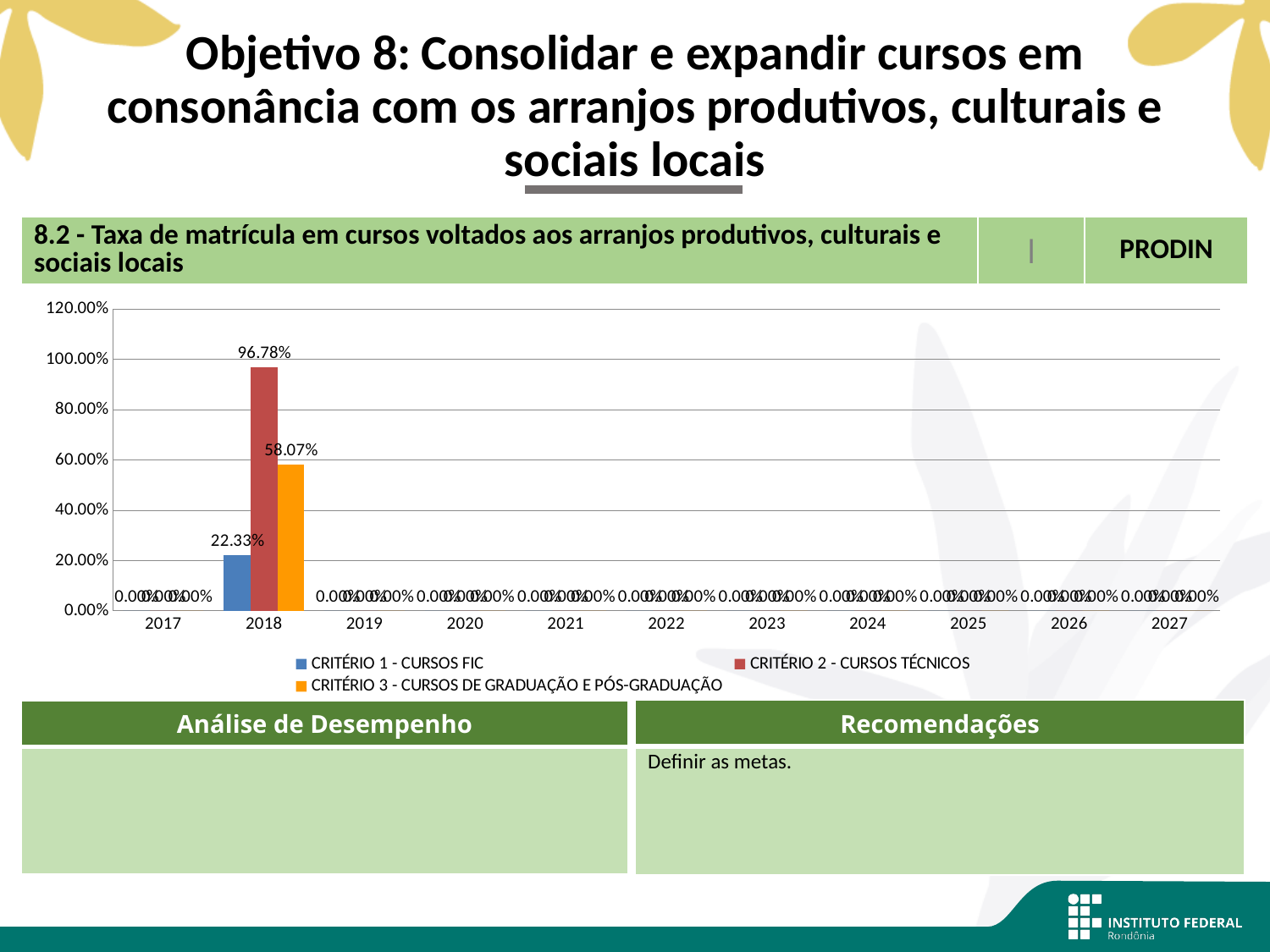
What is the value for CRITÉRIO 2 - CURSOS TÉCNICOS in 2018? 96.78% What kind of chart is shown on the slide? bar chart How many years are shown on the x axis? 11 Which series has the highest value in 2018? CRITÉRIO 2 - CURSOS TÉCNICOS What is the value for CRITÉRIO 3 - CURSOS DE GRADUAÇÃO E PÓS-GRADUAÇÃO in 2018? 58.07% Which year is the only one with non-zero values in the chart? 2018 What is the difference between the CRITÉRIO 2 and CRITÉRIO 3 values in 2018? 38.71% Is the value for CRITÉRIO 2 - CURSOS TÉCNICOS in 2018 greater or less than 80.00%? greater Which series has the lowest value in 2018? CRITÉRIO 1 - CURSOS FIC What is the value for CRITÉRIO 1 - CURSOS FIC in 2018? 22.33% How many series does the legend list? 3 Which is larger in 2018: CRITÉRIO 1 - CURSOS FIC or CRITÉRIO 3 - CURSOS DE GRADUAÇÃO E PÓS-GRADUAÇÃO? CRITÉRIO 3 - CURSOS DE GRADUAÇÃO E PÓS-GRADUAÇÃO